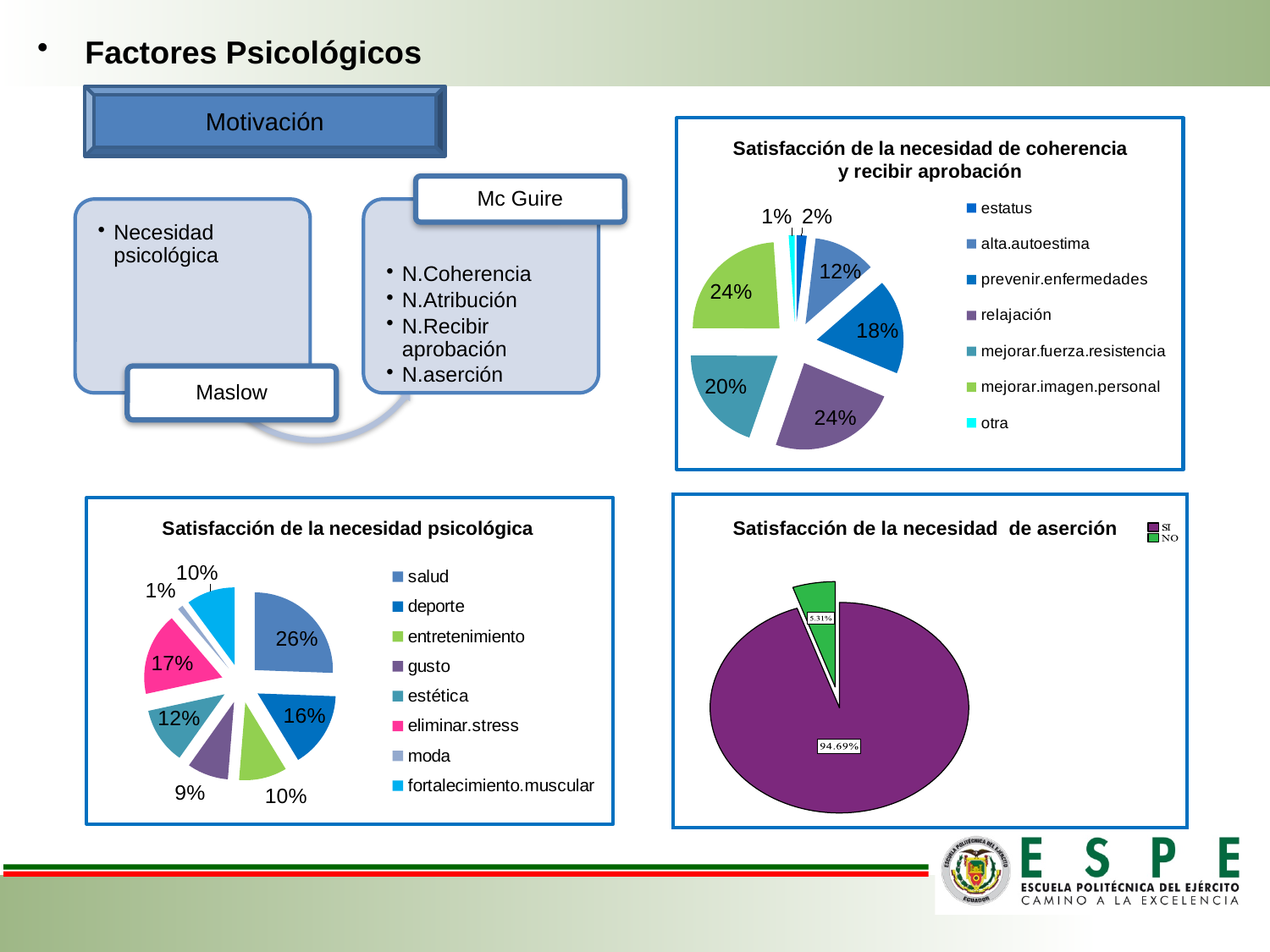
In the chart titled 'Satisfacción de la necesidad de coherencia y recibir aprobación', which is larger, prevenir.enfermedades or alta.autoestima? prevenir.enfermedades How many categories does the legend of the chart titled 'Satisfacción de la necesidad de coherencia y recibir aprobación' list? 7 In the chart titled 'Satisfacción de la necesidad de aserción', what percentage is shown for SI? 94.69% What type of chart is the chart titled 'Satisfacción de la necesidad de aserción'? pie chart In the chart titled 'Satisfacción de la necesidad de coherencia y recibir aprobación', what percentage is shown for relajación? 24% In the chart titled 'Satisfacción de la necesidad psicológica', which category has the smallest slice? moda In the chart titled 'Satisfacción de la necesidad psicológica', what percentage is shown for salud? 26% How many categories does the legend of the chart titled 'Satisfacción de la necesidad psicológica' list? 8 In the chart titled 'Satisfacción de la necesidad psicológica', which category has the largest slice? salud In the chart titled 'Satisfacción de la necesidad psicológica', what is the difference between the percentages for salud and deporte? 10% In the chart titled 'Satisfacción de la necesidad de coherencia y recibir aprobación', what percentage is shown for mejorar.fuerza.resistencia? 20% In the chart titled 'Satisfacción de la necesidad psicológica', what percentage is shown for eliminar.stress? 17%